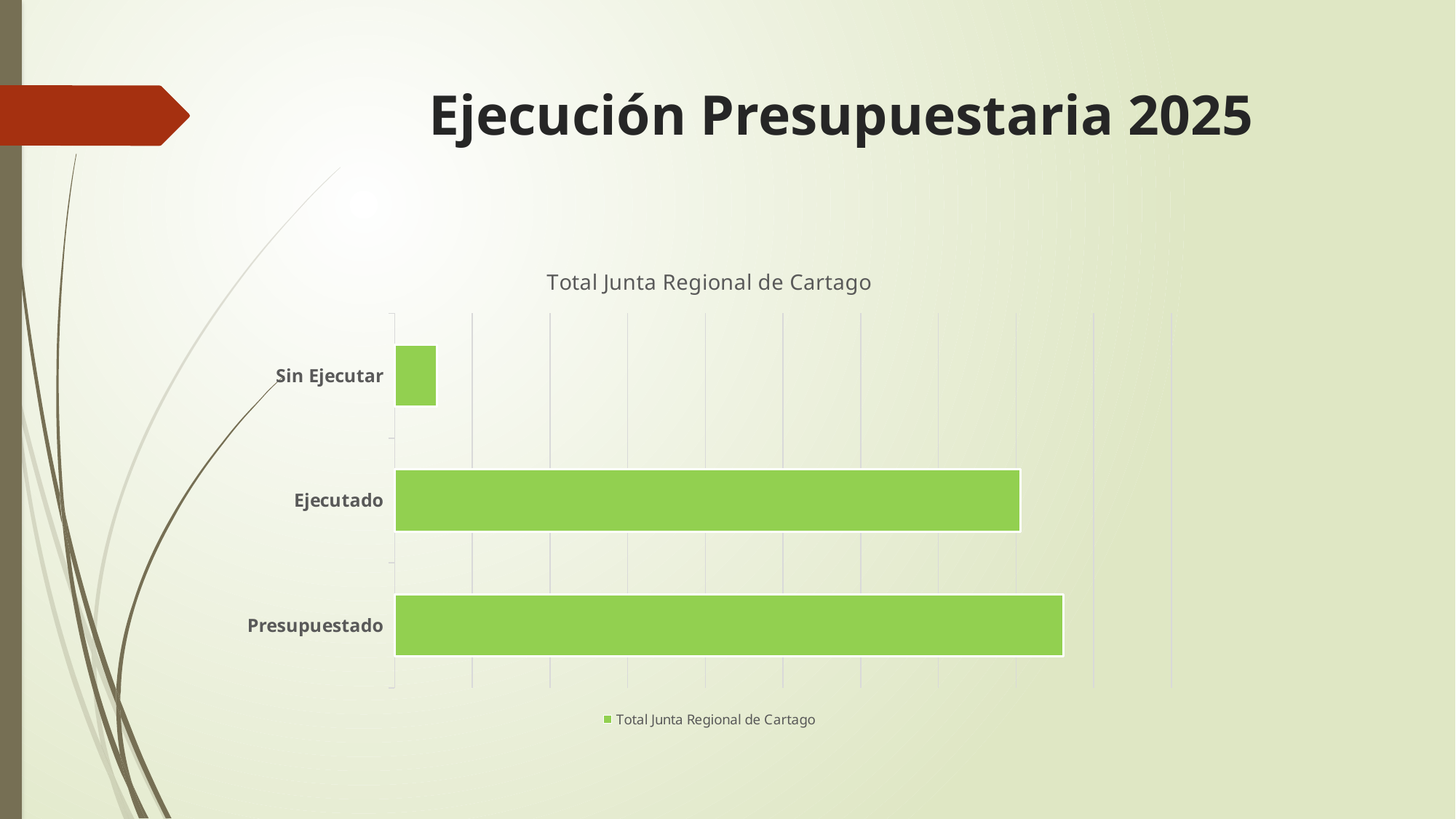
Which category is listed at the top of the chart? Sin Ejecutar What is the title of the chart? Total Junta Regional de Cartago How many series does the legend list? 1 Which is larger, the value for Ejecutado or the value for Sin Ejecutar? Ejecutado What kind of chart is shown on the slide? Bar chart Which category has the longest bar? Presupuestado Which is larger, the value for Presupuestado or the value for Ejecutado? Presupuestado What is the name of the series shown in the legend? Total Junta Regional de Cartago Which category has the shortest bar? Sin Ejecutar How many categories are plotted in the chart? 3